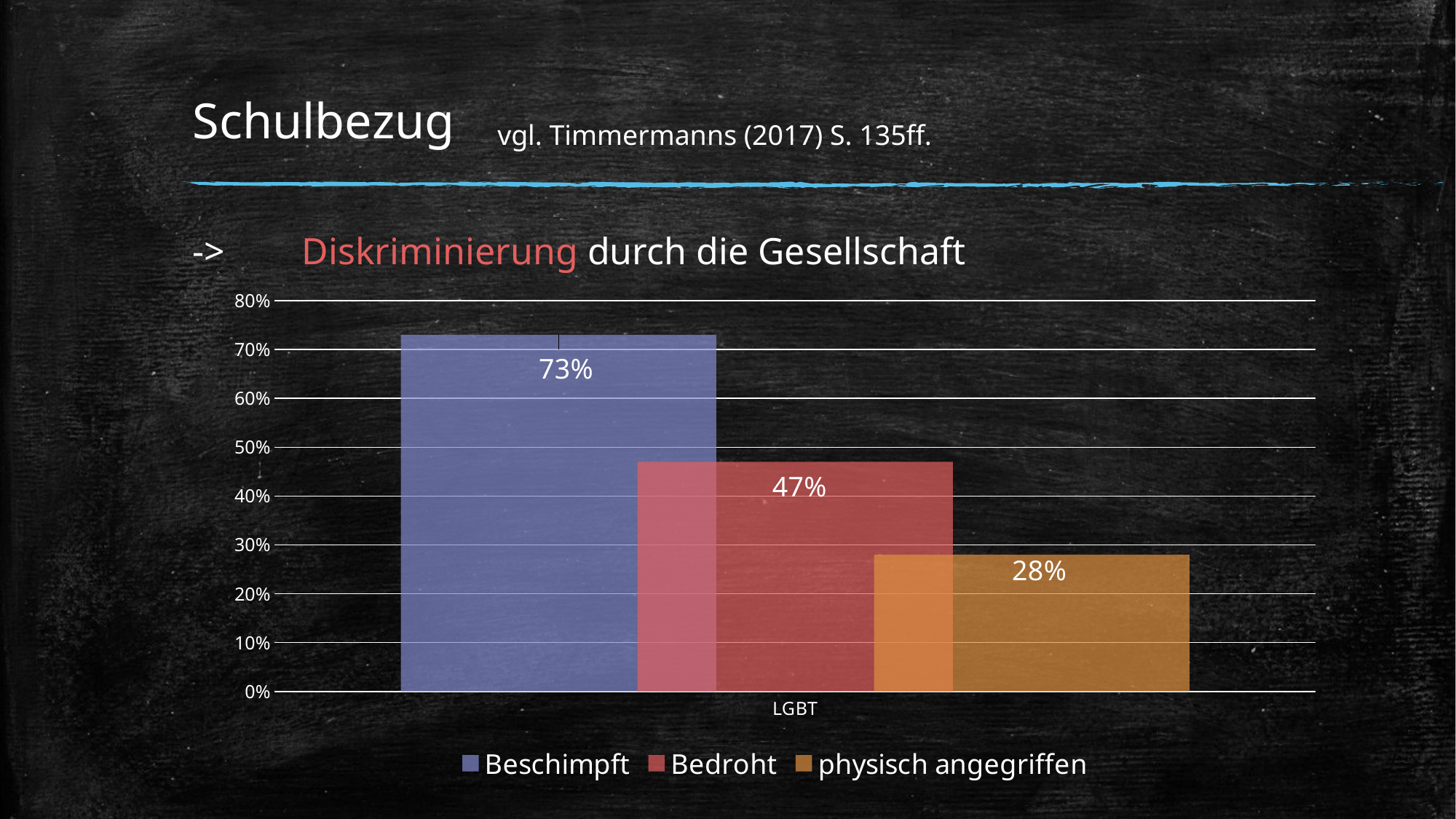
What is the value for physisch angegriffen? 28% Which is larger, the value for Bedroht or the value for physisch angegriffen? Bedroht What is the value for Beschimpft? 73% What kind of chart is shown on the slide? bar chart What is the category label on the x axis? LGBT How many series does the legend list? 3 What is the difference between the values for Beschimpft and Bedroht? 26% Which series has the lowest value? physisch angegriffen What is the difference between the values for Bedroht and physisch angegriffen? 19% Is the value for Bedroht greater or less than 50%? less What is the value for Bedroht? 47% Which series has the highest value? Beschimpft